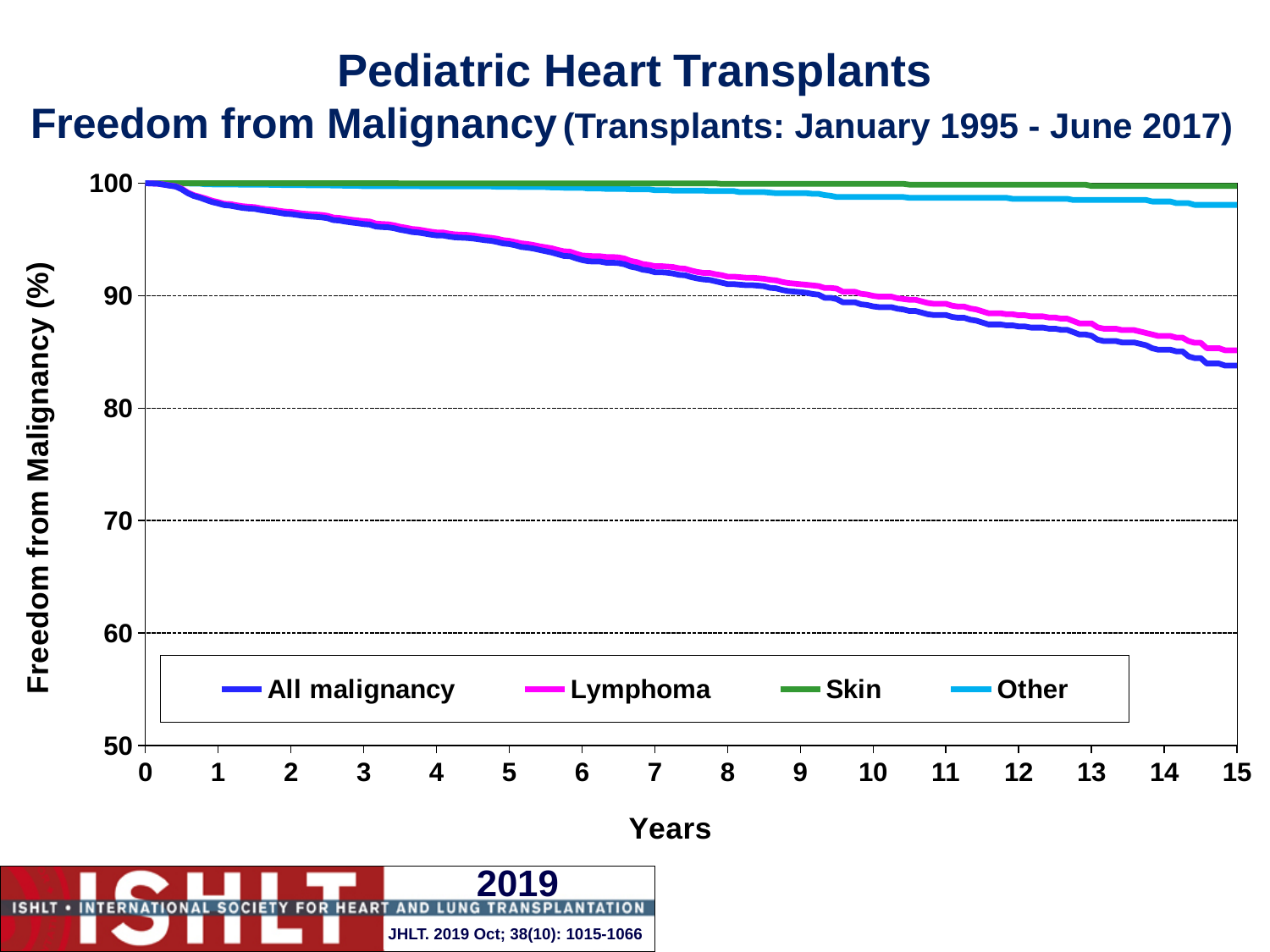
Is the value for All malignancy at 15 years greater or less than 80? greater How many series does the legend list? 4 Is the value for All malignancy at 15 years greater or less than 90? less What is the label of the y axis? Freedom from Malignancy (%) Does the All malignancy line rise or fall as years increase? fall Which series has the highest value at 15 years? Skin What kind of chart is shown on the slide? line chart Which series has the lowest value at 15 years? All malignancy Which series does the legend list first? All malignancy At 15 years, which is larger: the value for Skin or the value for Other? Skin Is the value for Lymphoma at 10 years greater or less than 80? greater